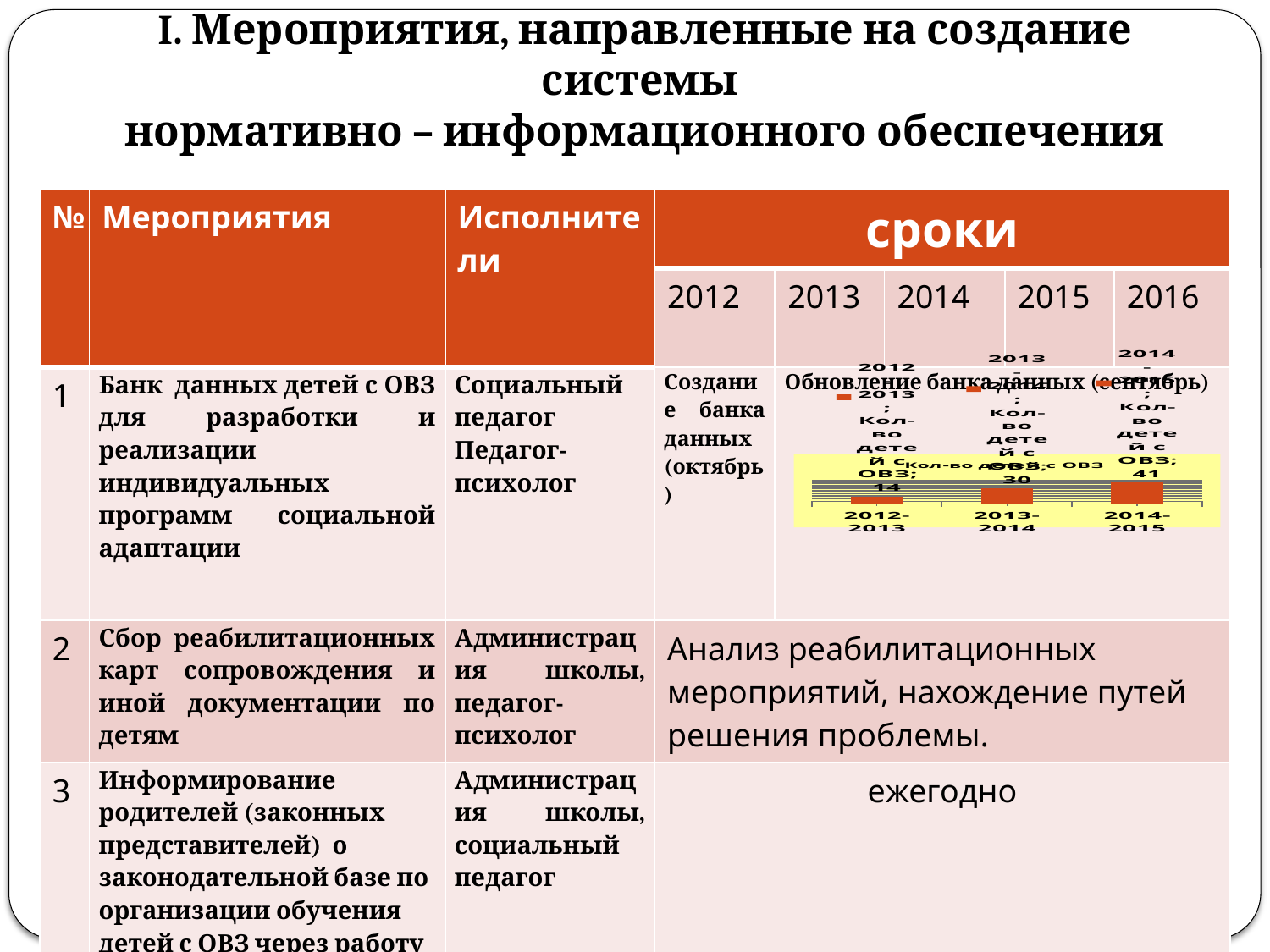
What type of chart is shown in the table row for 'Банк данных детей с ОВЗ'? bar chart Do the values on the bar chart rise or fall from 2012-2013 to 2014-2015? rise What is the value for 2013-2014 on the bar chart? 30 What is the value for 2012-2013 on the bar chart? 14 Which period has the lowest value on the bar chart? 2012-2013 What is the value for 2014-2015 on the bar chart? 41 Which is larger on the bar chart: the value for 2013-2014 or the value for 2014-2015? 2014-2015 Which period has the highest value on the bar chart? 2014-2015 What is the difference between the values for 2013-2014 and 2012-2013 on the bar chart? 16 What is the difference between the values for 2014-2015 and 2012-2013 on the bar chart? 27 How many categories (periods) are plotted on the bar chart? 3 What series name is shown in the bar chart's data labels? Кол-во детей с ОВЗ